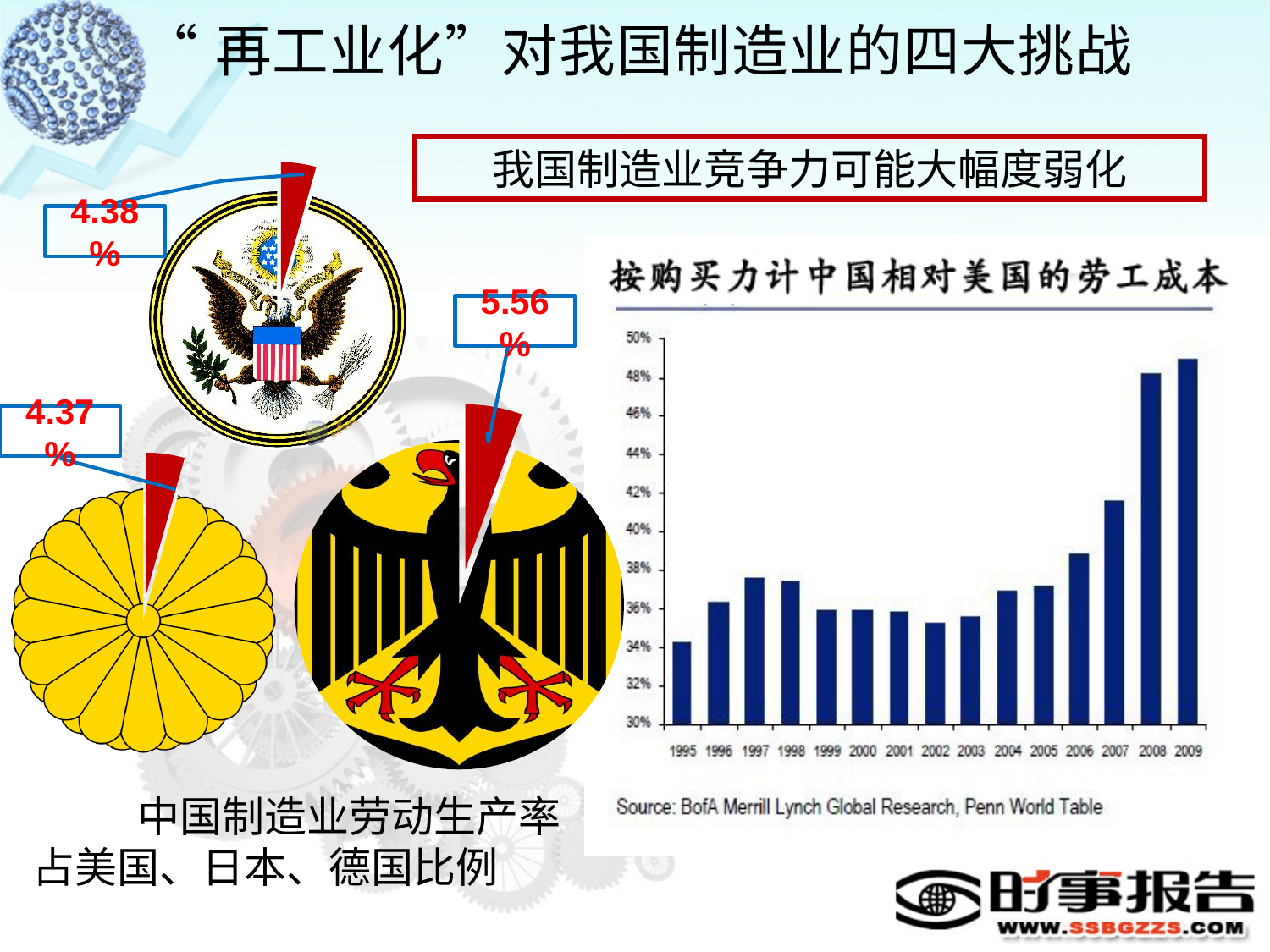
In the bar chart on the right, which year has the lowest value? 1995 In the bar chart on the right, do the values generally rise or fall from 2003 to 2009? rise In the bar chart on the right, which is larger, the value for 2007 or the value for 2008? 2008 In the bar chart on the right, is the value for 2007 greater or less than 40%? greater In the bar chart on the right, is the value for 2009 greater or less than 48%? greater In the bar chart on the right, is the value for 1995 greater or less than 36%? less What kind of chart is the chart titled 按购买力计中国相对美国的劳工成本 on the right of the slide? bar chart In the pie graphics on the left showing 中国制造业劳动生产率占美国、日本、德国比例, what is the value shown for the United States (the pie with the US seal)? 4.38% In the pie graphics on the left, what is the value shown for Germany (the pie with the German eagle)? 5.56% In the bar chart on the right, how many years are shown on the x axis? 15 In the bar chart on the right, which year has the highest value? 2009 In the pie graphics on the left, what is the value shown for Japan (the pie with the chrysanthemum)? 4.37%